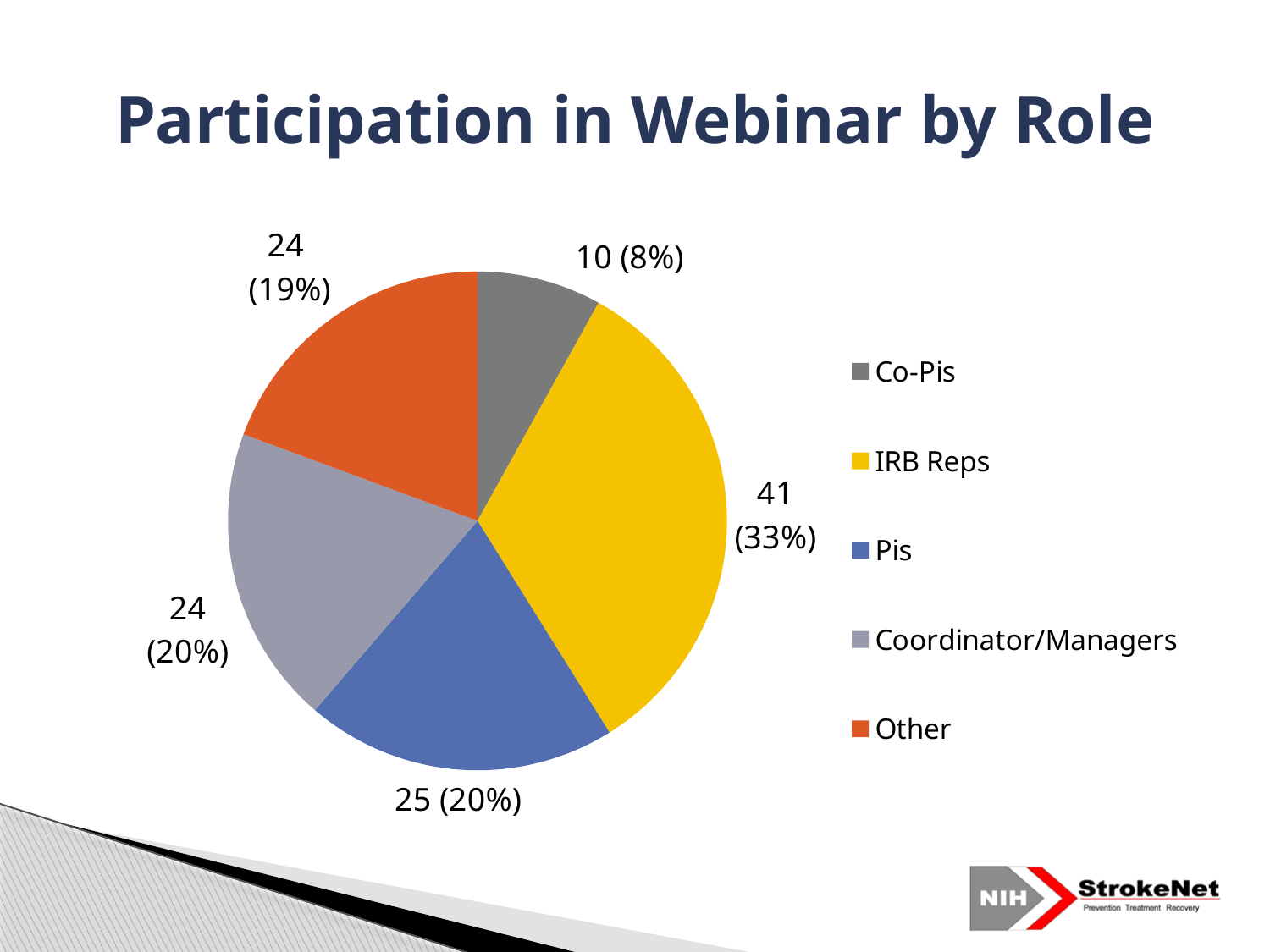
How many participants were Co-Pis? 10 How many participants were IRB Reps? 41 What is the difference between the number of IRB Reps and the number of Pis? 16 What is the title of the chart? Participation in Webinar by Role What is the total number of participants across all roles? 124 How many slices does the pie chart have? 5 Which role had the smallest number of participants? Co-Pis Which role had the largest number of participants? IRB Reps How many participants were Pis? 25 What share of participants were Other? 19% What share of participants were IRB Reps? 33% What type of chart is shown on the slide? Pie chart